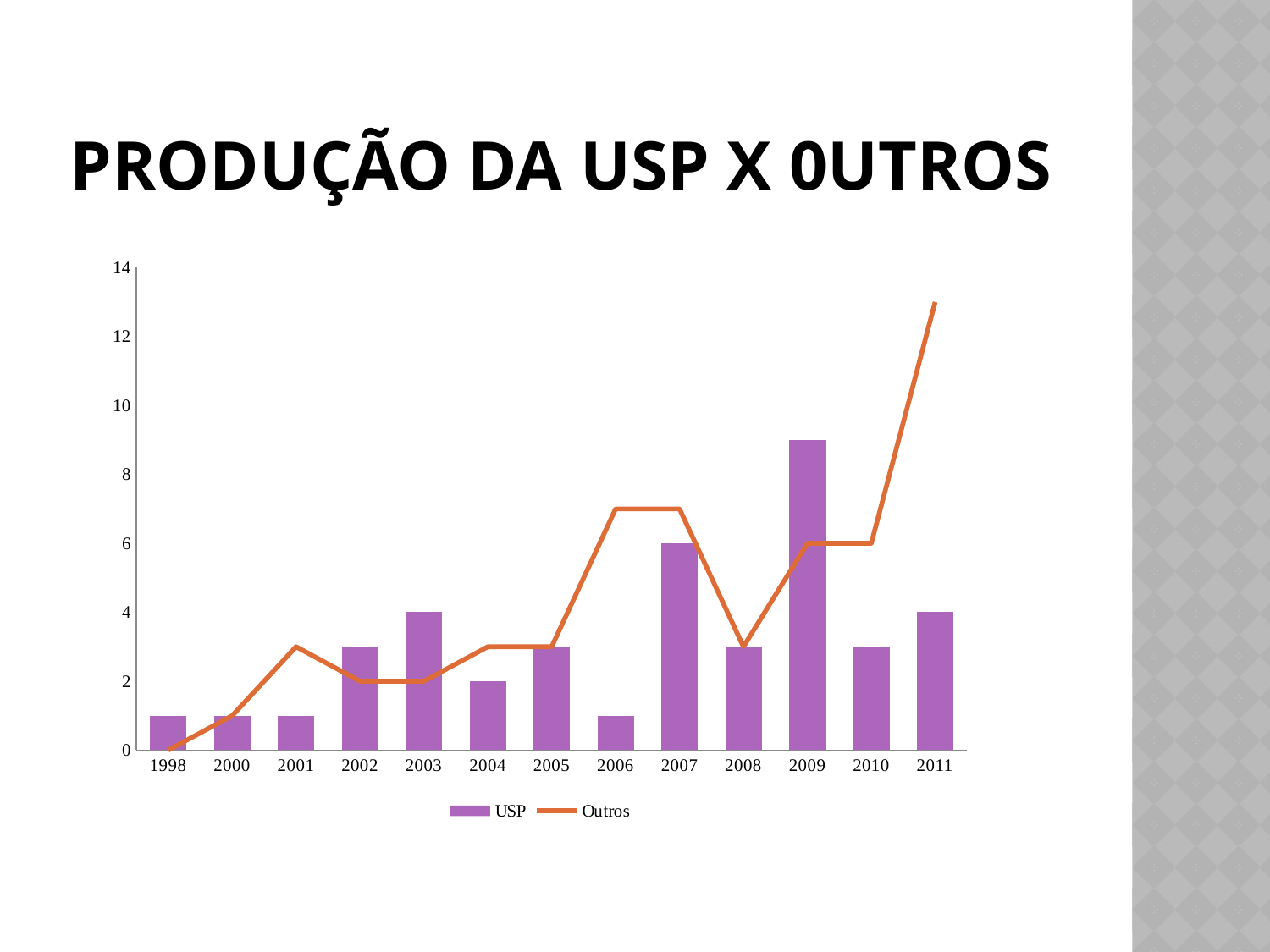
What is the USP value for 2004? 2 In which year is the USP bar highest? 2009 What is the difference between the USP values for 2007 and 2004? 4 How many years are shown on the x axis? 13 What is the USP value for 2007? 6 What kind of chart is shown on the slide? A combination bar and line chart What is the Outros value for 2010? 6 Is the Outros value for 2011 greater or less than 12? greater Is the USP value for 2009 greater or less than 8? greater How many series does the legend list? 2 In 2006, which is larger, USP or Outros? Outros In which year does the Outros line reach its highest value? 2011